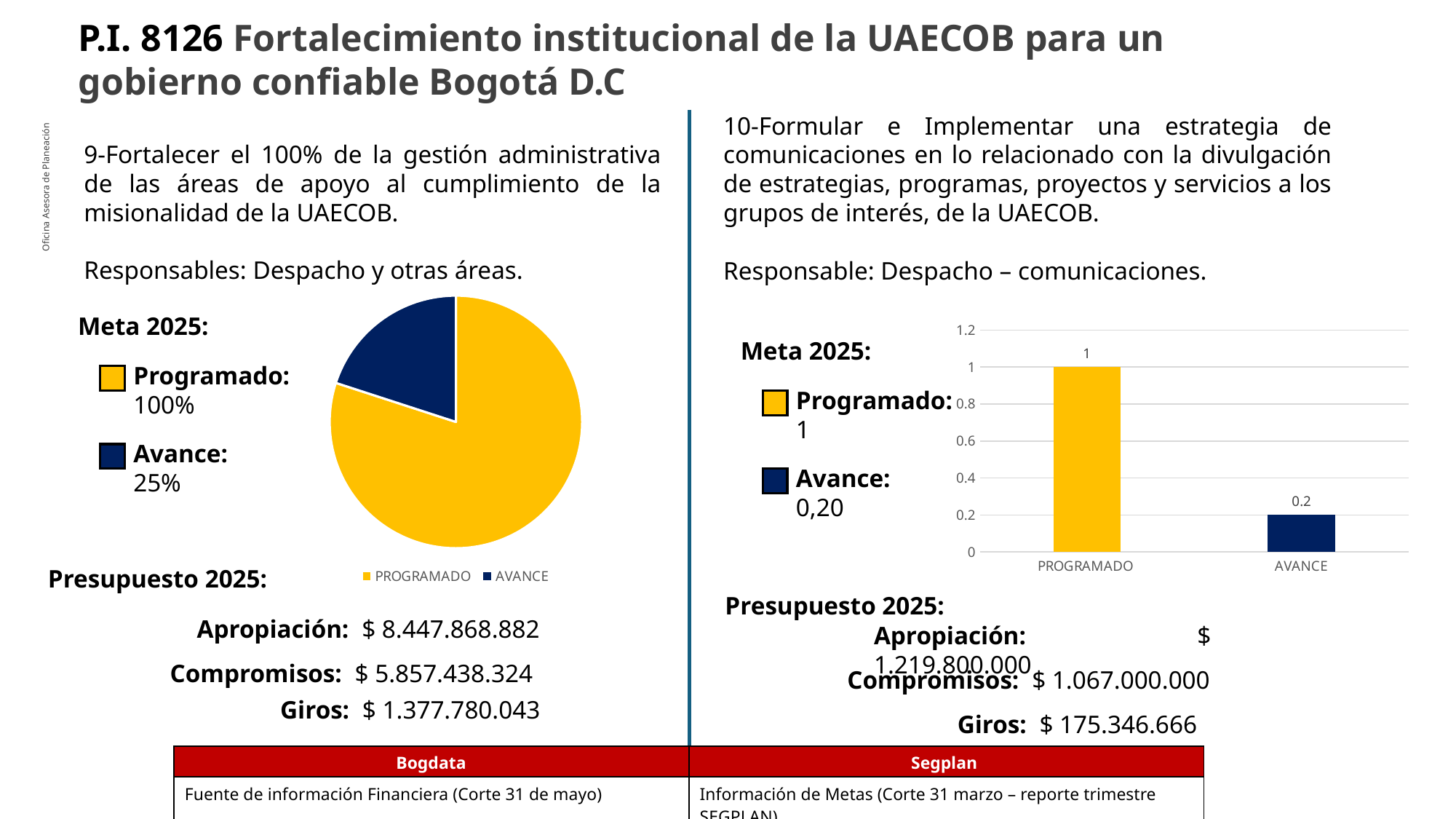
What kind of chart is shown on the right side of the slide? bar chart How many entries does the legend of the pie chart on the left list? 2 On the bar chart on the right, what is the value for PROGRAMADO? 1 On the bar chart on the right, is the value for AVANCE greater or less than 0.4? less What kind of chart is shown on the left side of the slide? pie chart On the bar chart on the right, what is the value for AVANCE? 0.2 On the bar chart on the right, which is larger, PROGRAMADO or AVANCE? PROGRAMADO On the bar chart on the right, what is the difference between the PROGRAMADO and AVANCE values? 0.8 On the pie chart on the left, which slice is larger, PROGRAMADO or AVANCE? PROGRAMADO On the bar chart on the right, which category has the highest value? PROGRAMADO How many categories are shown on the bar chart on the right? 2 On the bar chart on the right, which category has the lowest value? AVANCE